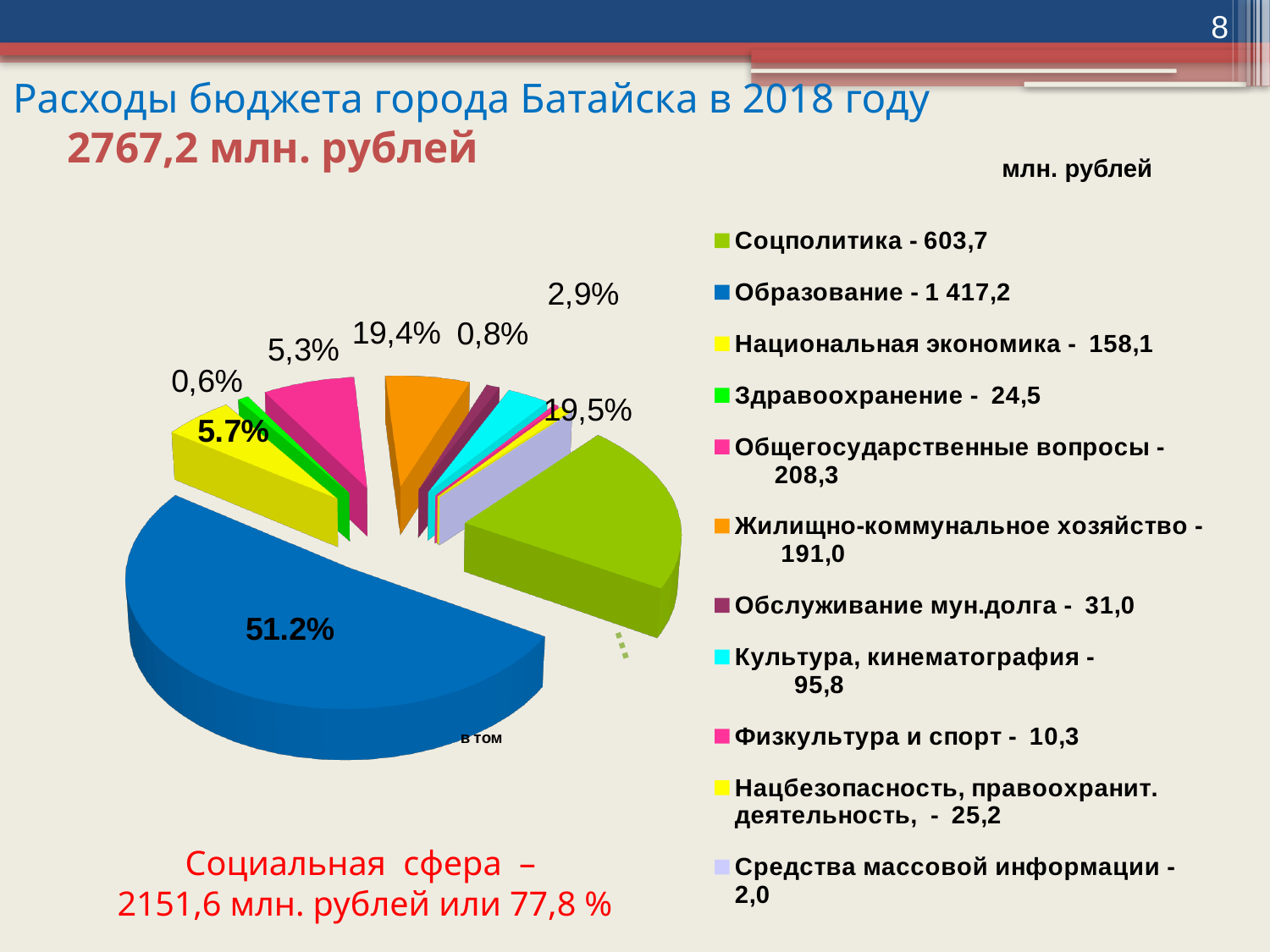
What is the value for Жилищно-коммунальное хозяйство? 191,0 What total budget expenditure is stated under the chart title? 2767,2 млн. рублей How many categories does the legend of the pie chart list? 11 What is the difference between the values for Общегосударственные вопросы and Национальная экономика? 50,2 What is the value for Соцполитика? 603,7 What is the value for Культура, кинематография? 95,8 Which category has the smallest value in the legend? Средства массовой информации Which category has the largest value in the legend? Образование What percentage label is printed on the largest (blue) slice of the pie? 51.2% What kind of chart is shown on the slide? pie chart In what units are the legend values given? млн. рублей Which is larger: the value for Здравоохранение or the value for Нацбезопасность, правоохранит. деятельность? Нацбезопасность, правоохранит. деятельность